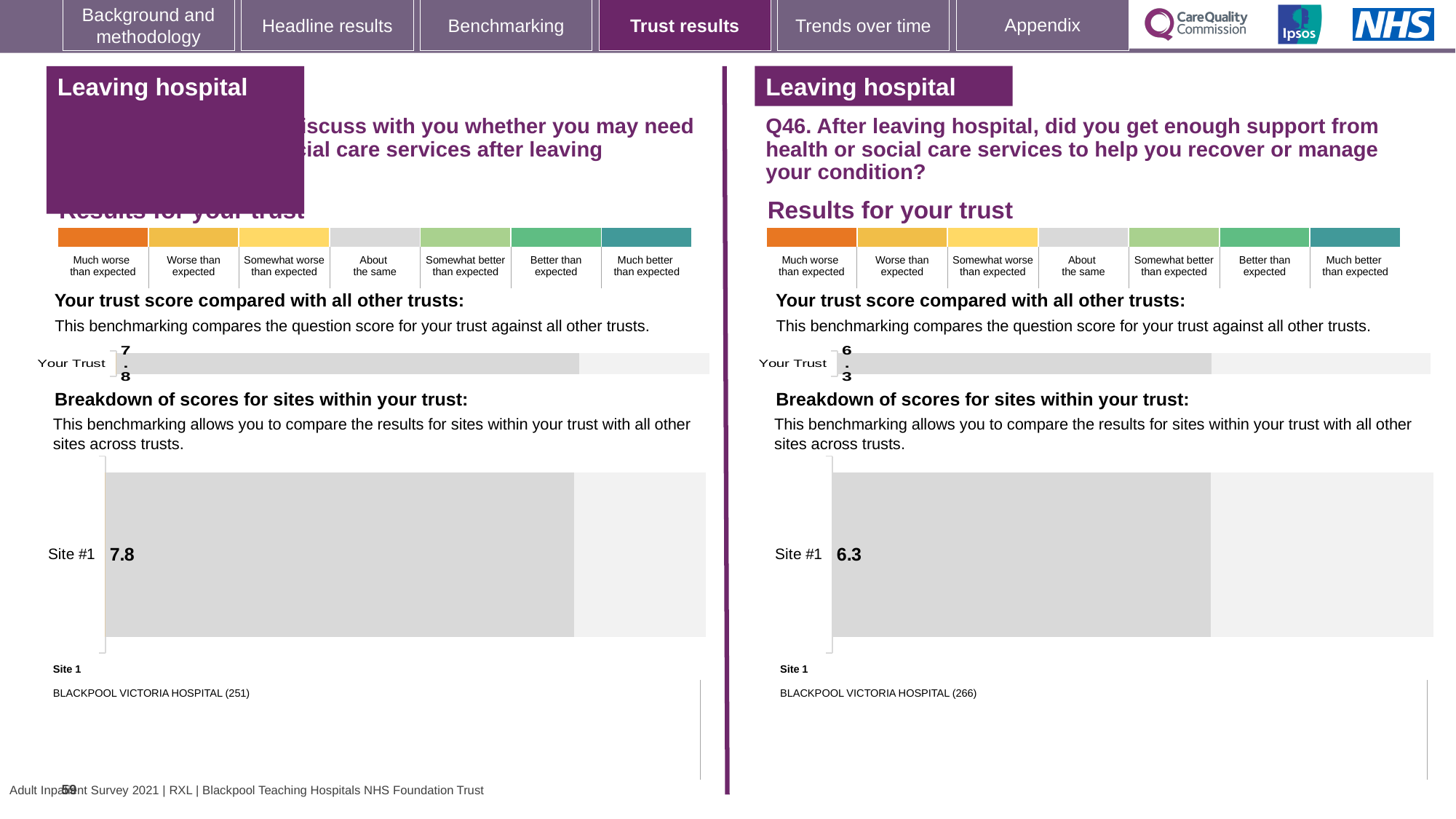
On the right-hand chart for Q46, what is the score shown for Your Trust? 6.3 On the right-hand breakdown of scores for sites chart (Q46), what is the score for Site #1? 6.3 How many sites are shown in the left-hand breakdown of scores for sites chart? 1 On the right-hand side (Q46), which hospital is listed as Site 1? BLACKPOOL VICTORIA HOSPITAL (266) On the left-hand breakdown of scores for sites chart, what is the score for Site #1? 7.8 What kind of chart is used to show the Your Trust score on the right-hand side (Q46)? Bar chart Which is larger: the Your Trust score on the left-hand chart or the Your Trust score on the right-hand chart (Q46)? Left-hand chart (7.8) How many categories does the colour scale legend above the left-hand chart list, from 'Much worse than expected' to 'Much better than expected'? 7 Which is larger: the Site #1 score on the left-hand chart or the Site #1 score on the right-hand chart (Q46)? Left-hand chart (7.8) What is the difference between the Your Trust score on the left-hand chart and the Your Trust score on the right-hand chart (Q46)? 1.5 On the left-hand chart, what is the score shown for Your Trust? 7.8 How many sites are shown in the right-hand breakdown of scores for sites chart (Q46)? 1